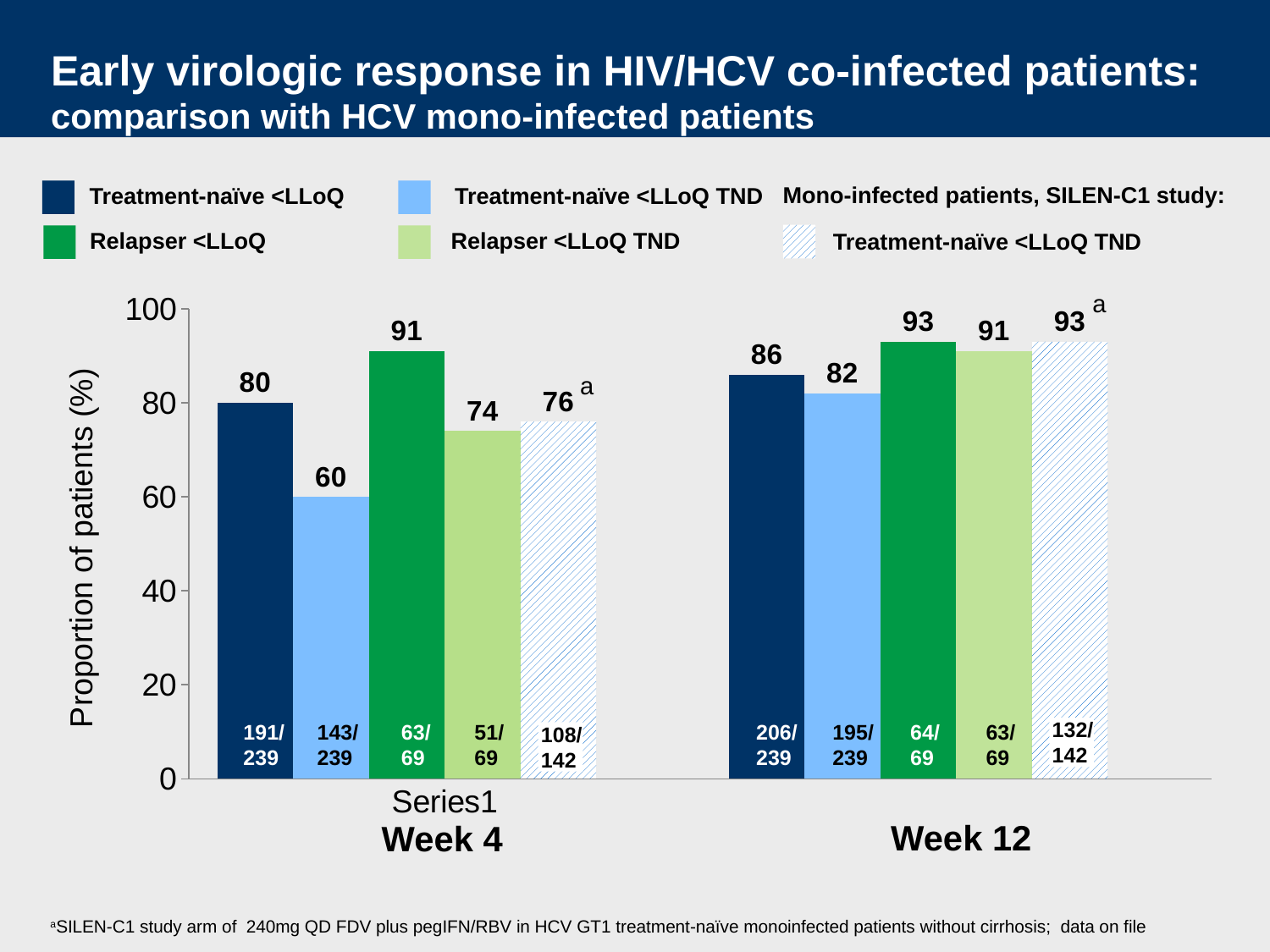
Which bar is the lowest at Week 4? Treatment-naïve <LLoQ TND What is the label of the y axis? Proportion of patients (%) What is the value for Relapser <LLoQ TND at Week 12? 91 Which bar is the highest at Week 4? Relapser <LLoQ What is the value for Relapser <LLoQ at Week 12? 93 What is the difference between the Treatment-naïve <LLoQ TND values at Week 12 and Week 4? 22 What kind of chart is shown on the slide? bar chart How many bars are shown in the Week 12 group? 5 Which is larger at Week 12: Treatment-naïve <LLoQ or Treatment-naïve <LLoQ TND? Treatment-naïve <LLoQ What is the value for Treatment-naïve <LLoQ TND at Week 4? 60 Does the Relapser <LLoQ TND value rise or fall from Week 4 to Week 12? rise What is the value for Treatment-naïve <LLoQ at Week 4? 80